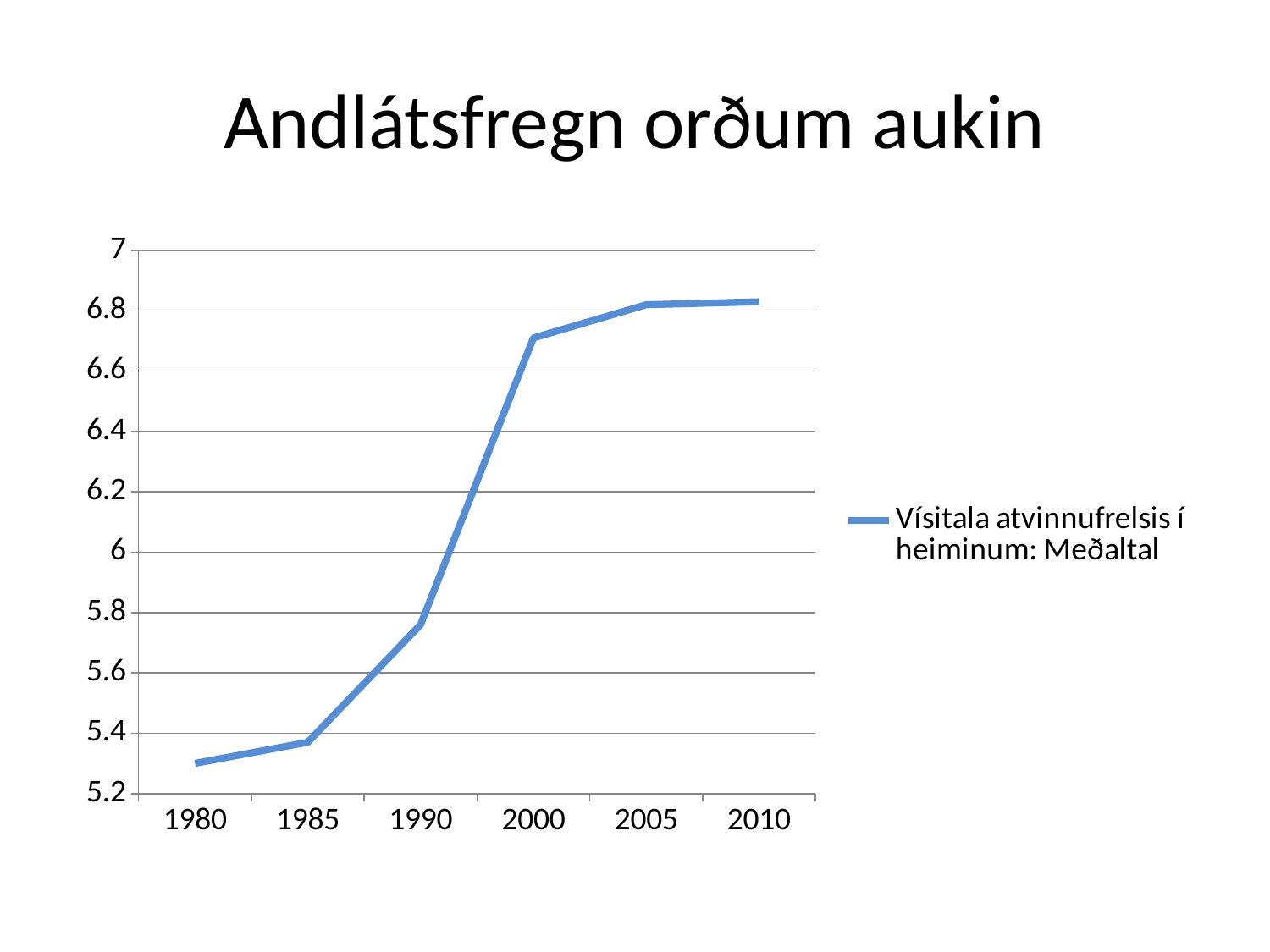
Is the value for 1980 greater or less than 5.4? less Which year has a higher value, 1990 or 2000? 2000 Is the value for 1990 greater or less than 6? less Is the value for 2000 greater or less than 6.6? greater What kind of chart is shown on the slide? line chart Which year has the lowest value? 1980 Which year has a higher value, 1985 or 2005? 2005 How many years are plotted along the x axis? 6 What is the name of the series shown in the legend? Vísitala atvinnufrelsis í heiminum: Meðaltal Do the values rise or fall from 1980 to 2010? rise How many series does the legend list? 1